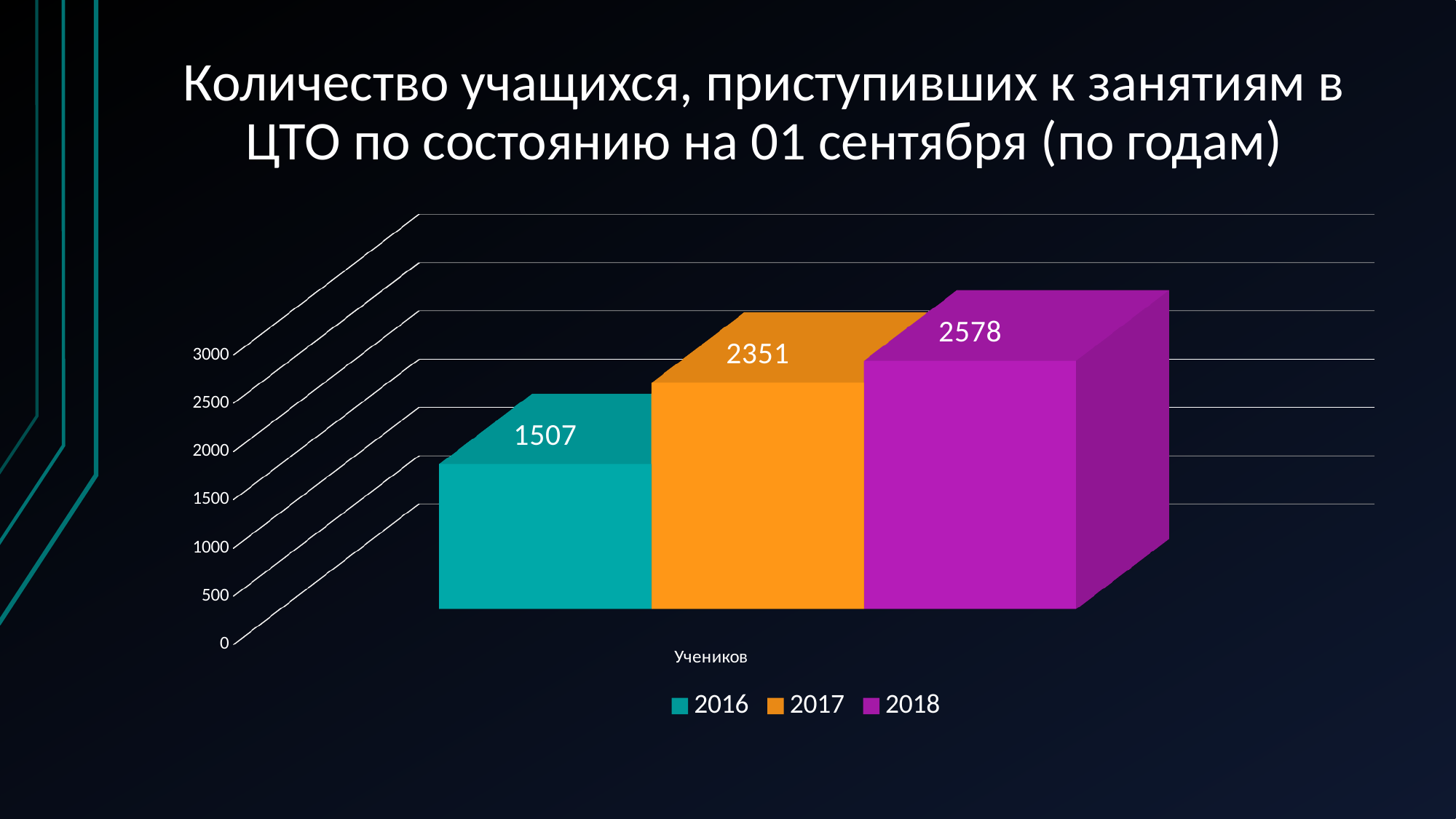
Which is larger, the value for 2016 or the value for 2017? 2017 What kind of chart is shown on the slide? bar chart How many series does the legend list? 3 What is the value for 2016? 1507 What is the value for 2017? 2351 What is the value for 2018? 2578 Do the values rise or fall from 2016 to 2018? rise What is the label on the category axis of the chart? Учеников What is the difference between the values for 2018 and 2017? 227 Which year has the highest value? 2018 Which year has the lowest value? 2016 What is the difference between the values for 2017 and 2016? 844